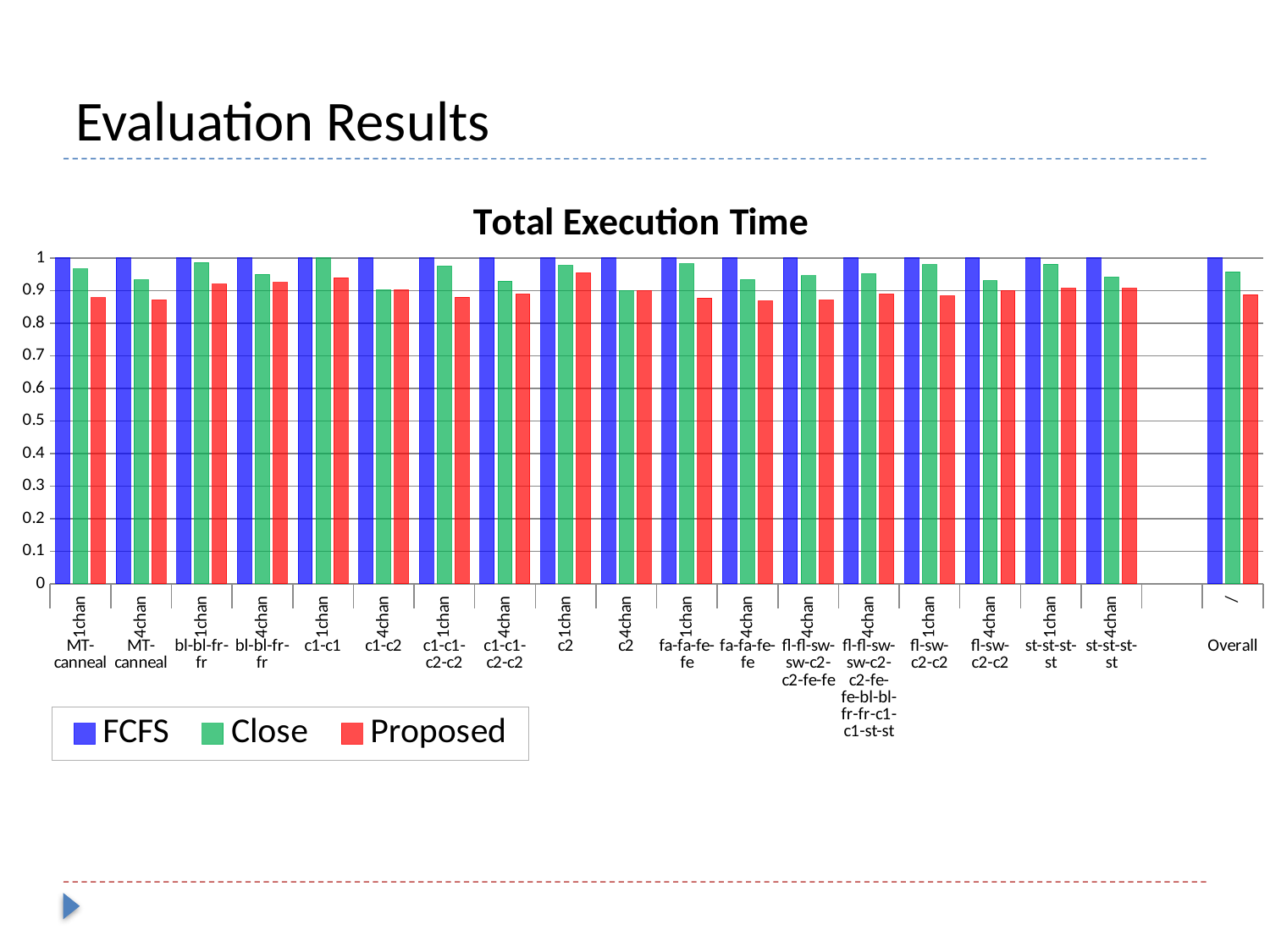
Is the Proposed value for fa-fa-fe-fe 4chan greater or less than 0.9? less Which series has the highest value in every category group? FCFS Is the Proposed value for c2 1chan greater or less than 0.9? greater Is the Close value for bl-bl-fr-fr 1chan greater or less than 0.9? greater What is the FCFS value for MT-canneal 1chan? 1 What is the FCFS value for the Overall category? 1 How many series does the legend list? 3 For MT-canneal 1chan, which is larger: the Close value or the Proposed value? Close Which series are listed in the legend? FCFS, Close, Proposed How many category groups are shown along the x axis, including Overall? 19 What type of chart is shown on the slide? Bar chart What is the title of the chart? Total Execution Time